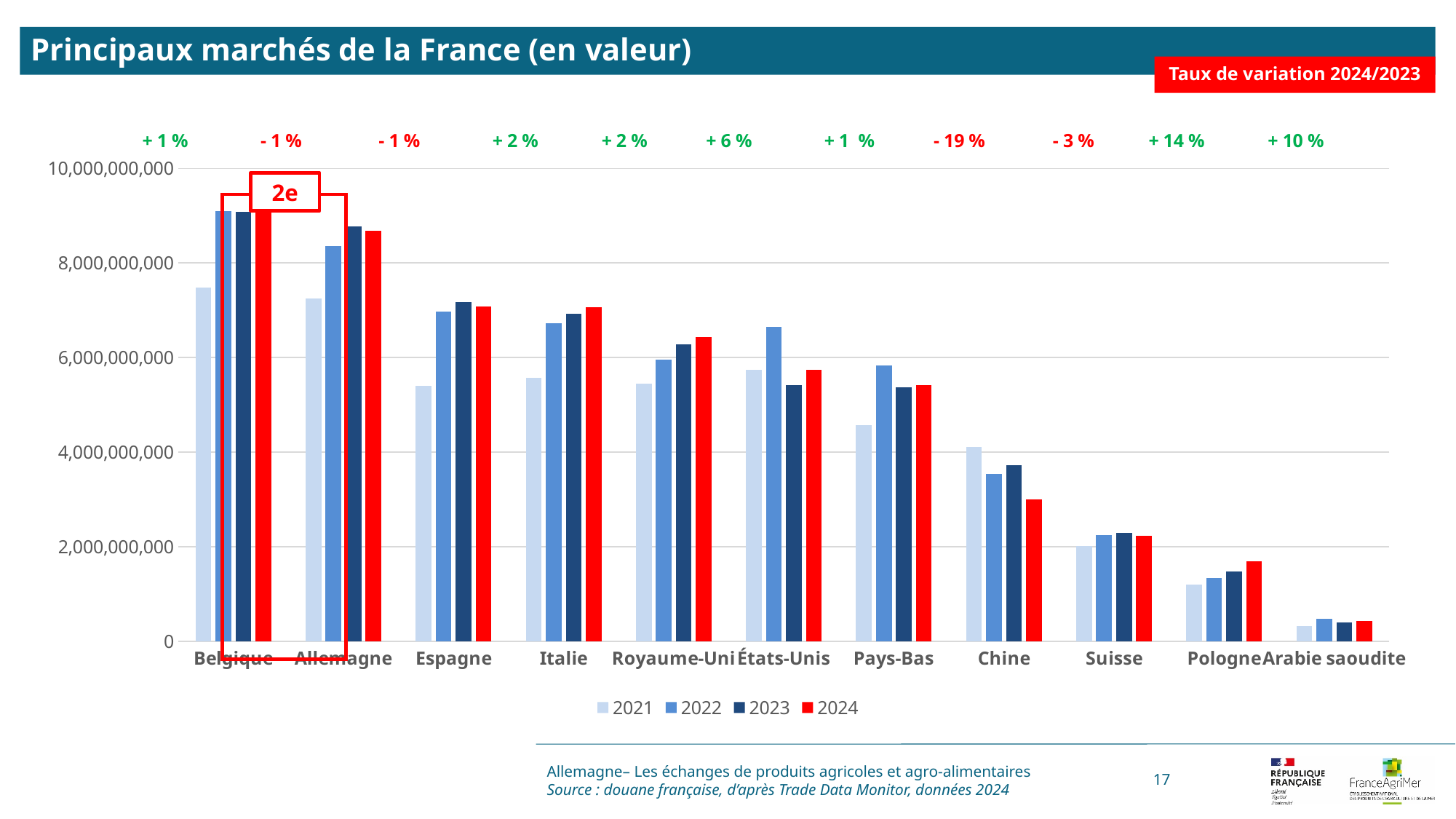
Do the 2024 values generally rise or fall from left to right across the countries? fall What kind of chart is shown on the slide? bar chart Which is larger for Chine: the 2021 value or the 2024 value? 2021 Is the 2024 value for Allemagne greater or less than 8,000,000,000? greater How many series does the legend list? 4 Is the 2024 value for Chine greater or less than 4,000,000,000? less Which country has the lowest 2024 value? Arabie saoudite Which country has the highest 2024 value? Belgique What is the 2024/2023 variation rate shown for Chine? - 19 % How many countries are shown on the x axis of the chart? 11 What is the 2024/2023 variation rate shown for Pologne? + 14 %